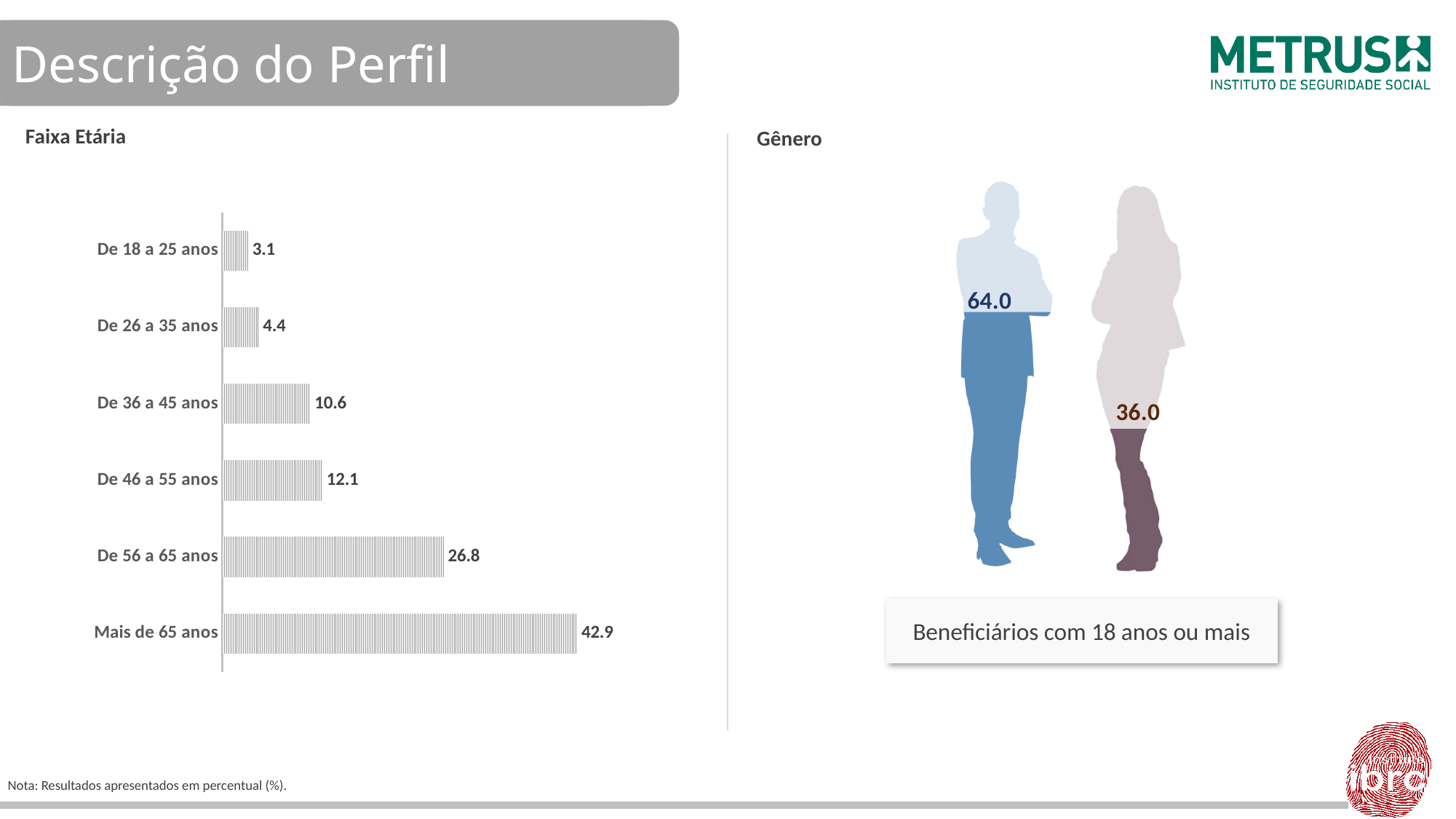
In the Gênero graphic, what is the difference between the male and female values? 28.0 In the Faixa Etária chart, do the values rise or fall going from the youngest age group to the oldest? Rise In the Faixa Etária chart, which age group has the lowest value? De 18 a 25 anos In the Faixa Etária chart, which is larger: the value for De 46 a 55 anos or De 26 a 35 anos? De 46 a 55 anos How many age groups are shown in the Faixa Etária chart? 6 In the Faixa Etária chart, what is the value for De 36 a 45 anos? 10.6 In the Gênero graphic, what is the value shown for the female figure? 36.0 In the Gênero graphic, what is the value shown for the male figure? 64.0 In the Faixa Etária chart, what is the value for De 56 a 65 anos? 26.8 What kind of chart is the Faixa Etária chart? Bar chart In the Faixa Etária chart, which age group has the highest value? Mais de 65 anos In the Faixa Etária chart, what is the difference between the values for Mais de 65 anos and De 56 a 65 anos? 16.1